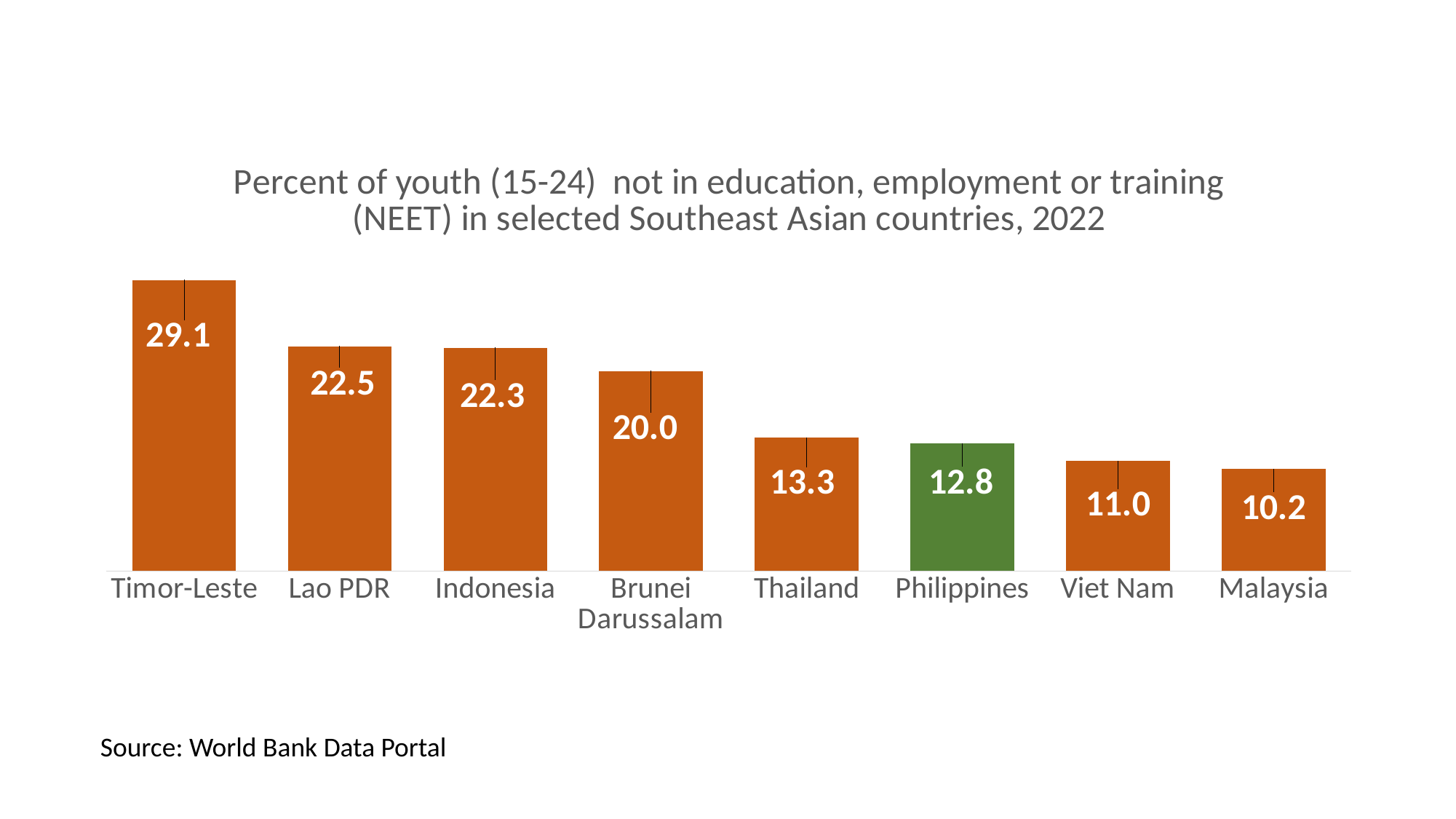
What is the difference between the values for Timor-Leste and Malaysia? 18.9 Which has a higher value, Thailand or Viet Nam? Thailand What is the difference between the values for Lao PDR and Indonesia? 0.2 Do the values rise or fall from left to right across the chart? Fall What is the value shown for Brunei Darussalam? 20.0 What is the NEET percentage for Timor-Leste? 29.1 What is the value shown for the Philippines? 12.8 Which country's bar is coloured green instead of orange? Philippines Which country has the highest NEET percentage? Timor-Leste Which country has the lowest NEET percentage? Malaysia How many countries are shown in the chart? 8 What type of chart is shown on the slide? Bar chart